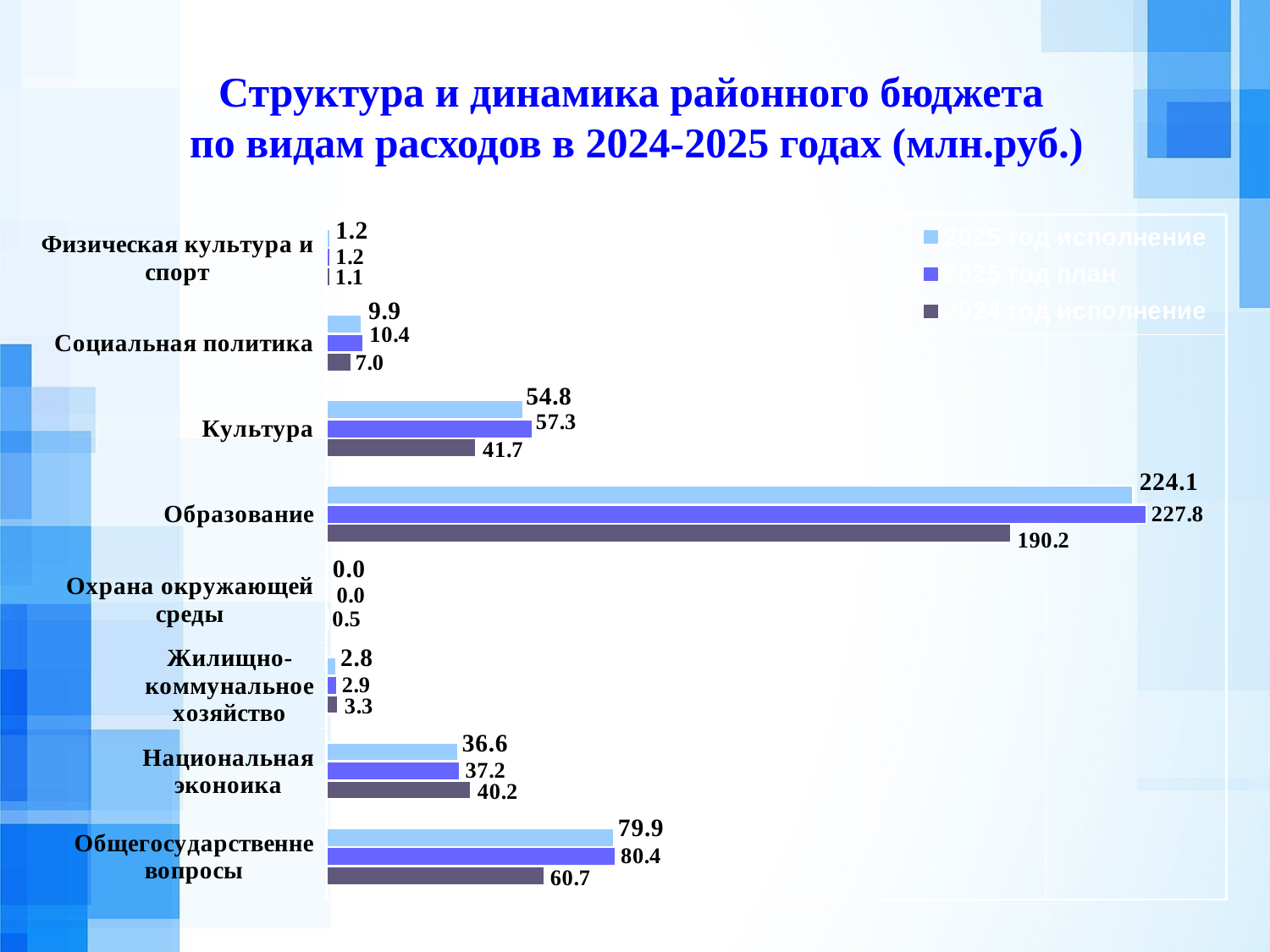
Which category has the lowest value in the 2024 год исполнение series? Охрана окружающей среды How many series does the legend list? 3 What is the title of the chart? Структура и динамика районного бюджета по видам расходов в 2024-2025 годах (млн.руб.) Which category has the highest value in the 2025 год исполнение series? Образование What is the value for Образование in the 2025 год план series? 227.8 What is the difference between the 2025 год план and 2024 год исполнение values for Образование? 37.6 What type of chart is shown on the slide? bar chart How many expenditure categories are shown on the chart? 8 Which is larger for Национальная экономика: the 2025 год исполнение value or the 2024 год исполнение value? 2024 год исполнение What is the value for Культура in the 2024 год исполнение series? 41.7 What is the value for Общегосударственне вопросы in the 2025 год исполнение series? 79.9 What is the value for Социальная политика in the 2025 год план series? 10.4